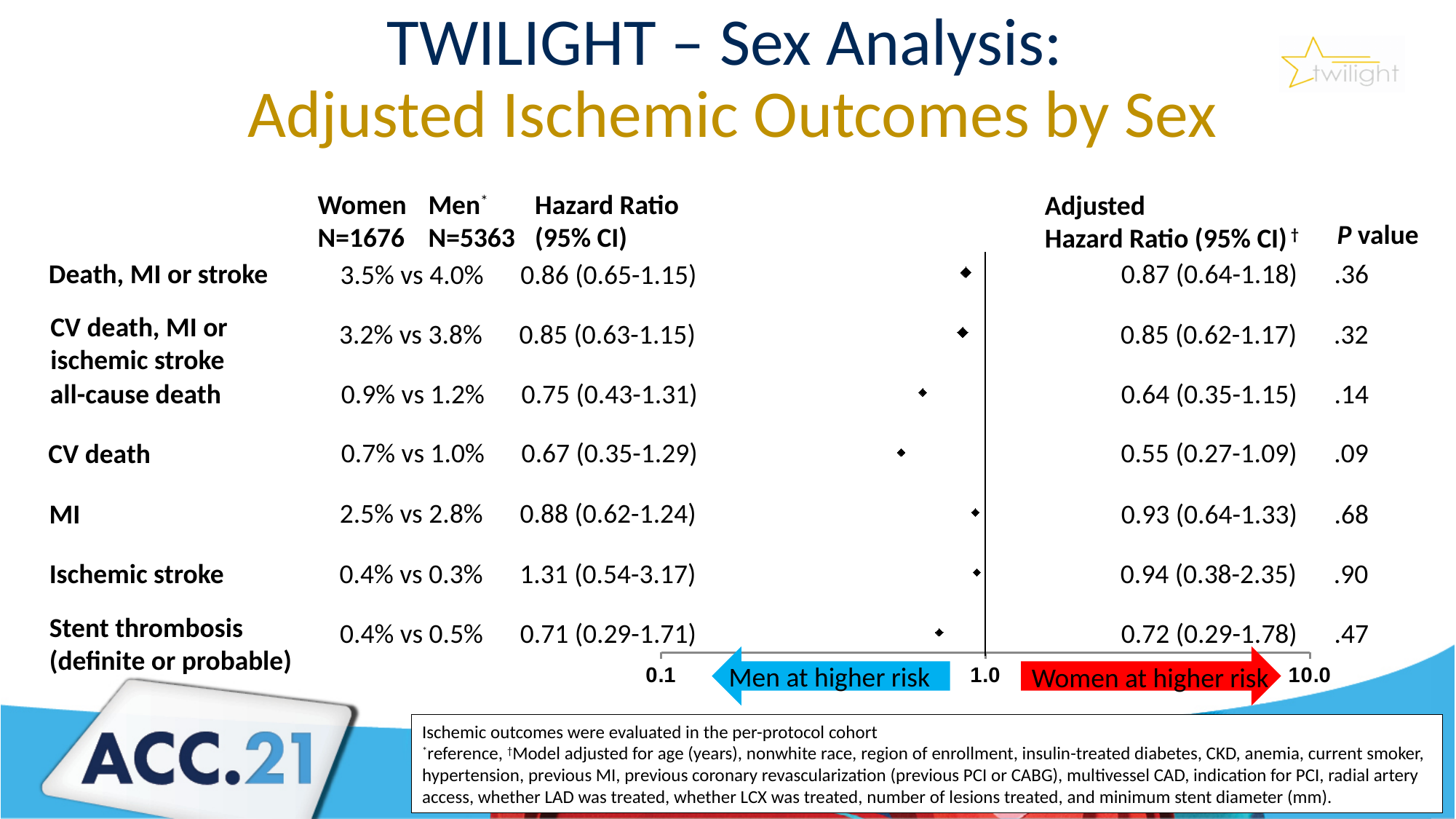
Is the plotted point for CV death greater or less than 1.0? less Which outcome has the lowest P value? CV death What is the event rate for women for MI? 2.5% What is the P value for MI? .68 What is the unadjusted hazard ratio (95% CI) for ischemic stroke? 1.31 (0.54-3.17) Which has the larger adjusted hazard ratio, all-cause death or MI? MI What kind of chart is shown on the slide? Forest plot What is the adjusted hazard ratio (95% CI) for CV death? 0.55 (0.27-1.09) What is the difference between the men's and women's event rates for Death, MI or stroke? 0.5% Which outcome has the lowest adjusted hazard ratio? CV death What does the blue arrow below the forest plot axis say? Men at higher risk How many outcomes are plotted in the forest plot? 7